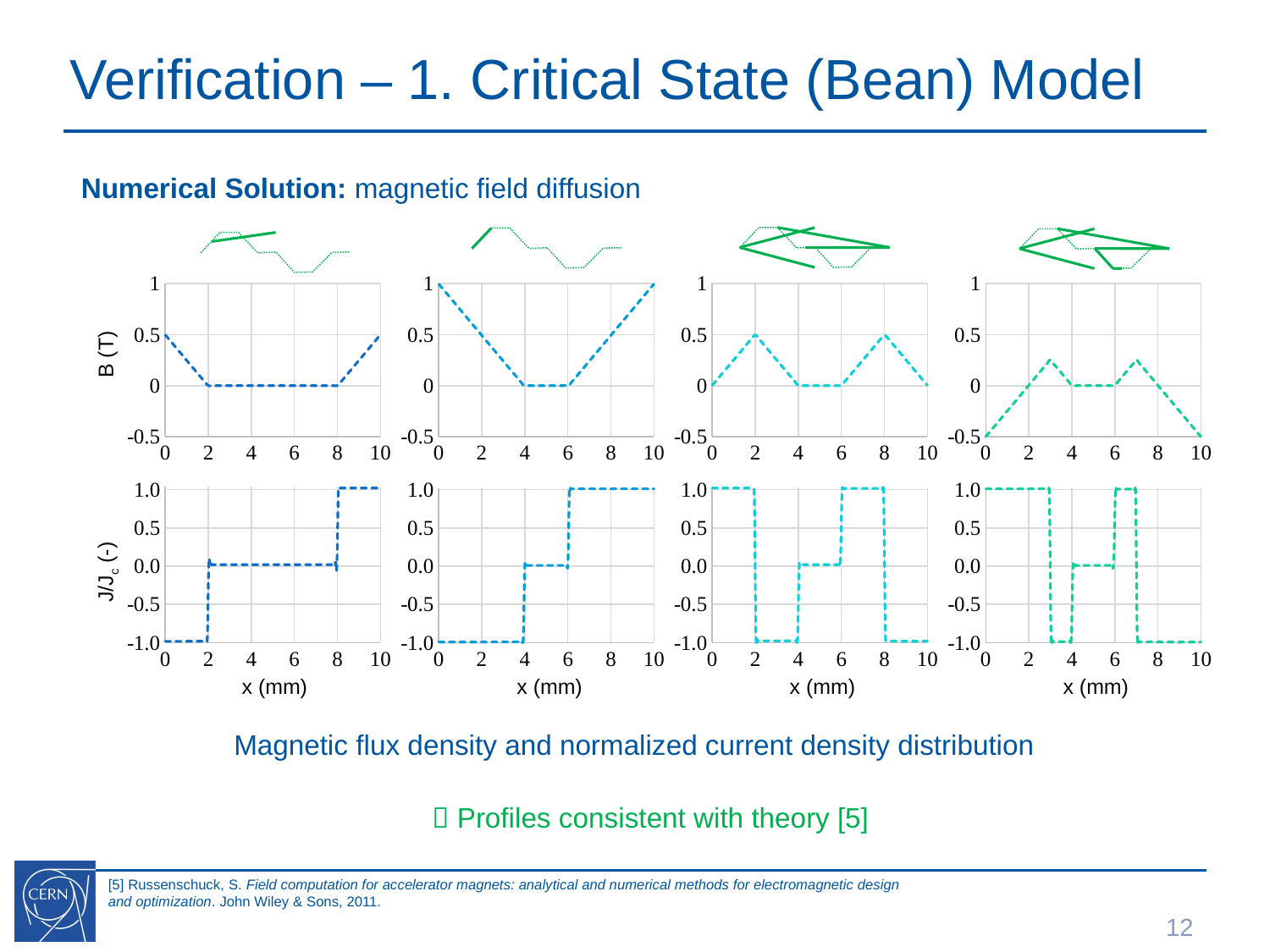
In the top-left B (T) chart, what is the value of B at x = 0? 0.5 In the second B (T) chart from the left, does B rise or fall as x goes from 0 to 4? fall How many charts are shown on the slide in total? 8 What kind of chart is the top-left B (T) chart? line chart In the second B (T) chart from the left, what is the value of B at x = 0? 1 In the rightmost B (T) chart, what is the value of B at x = 0? -0.5 What is the label of the x axis on the charts? x (mm) In the third B (T) chart from the left, what is the value of B at x = 2? 0.5 In the second B (T) chart from the left, what is the value of B at x = 4? 0 In the bottom-left J/Jc chart, what is the value of J/Jc at x = 1? -1.0 In the bottom-left J/Jc chart, what is the value of J/Jc at x = 9? 1.0 What is the label of the y axis on the bottom row of charts? J/Jc (-)